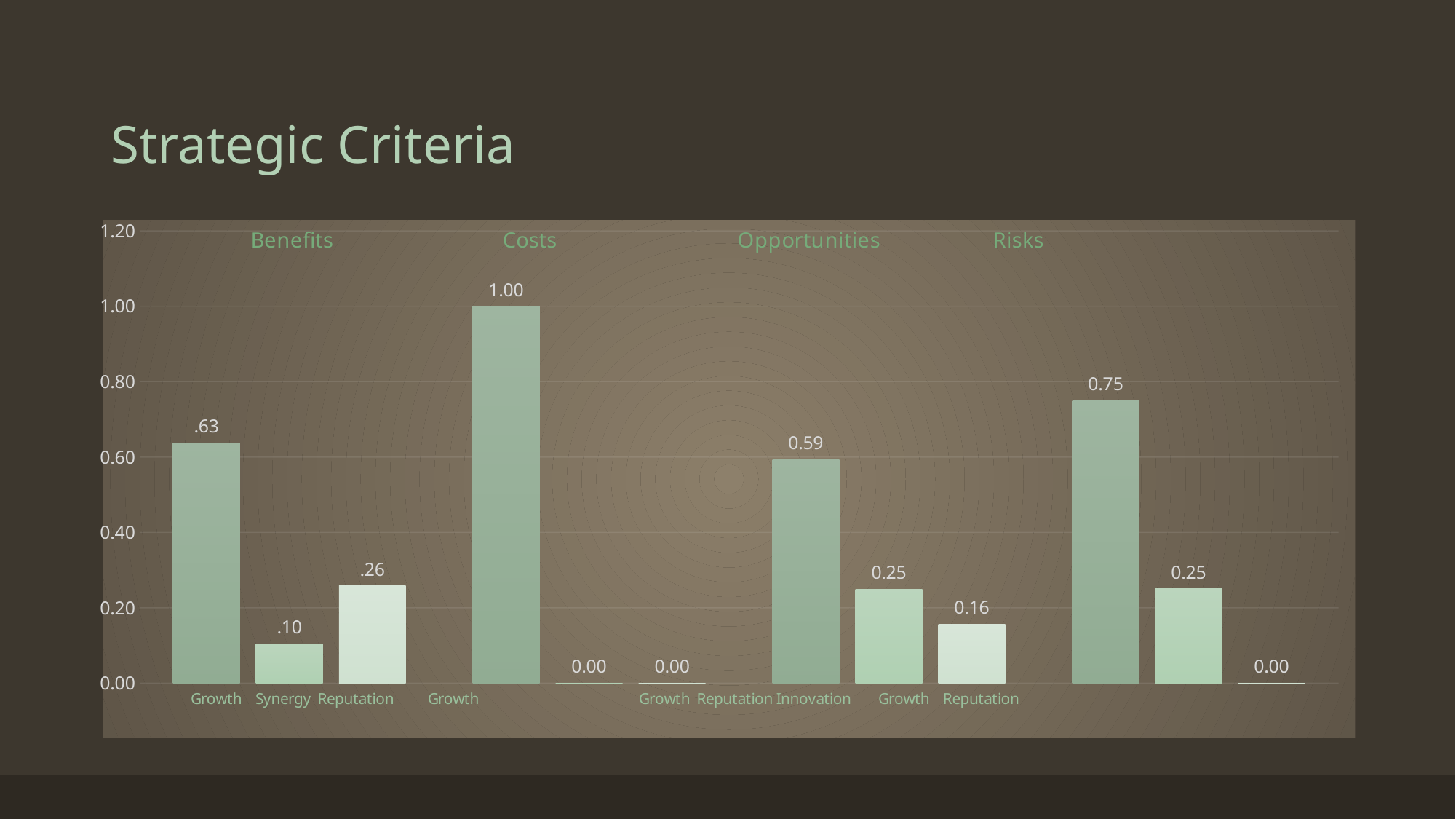
Which bar has the highest value on the chart? Growth (Costs), 1.00 What is the value of the Reputation bar in the Benefits group? .26 What kind of chart is shown on the slide? Bar chart What is the value of the tallest bar in the Opportunities group? 0.59 What is the value of the Growth bar in the Costs group? 1.00 What is the value of the Synergy bar in the Benefits group? .10 What is the value of the tallest bar in the Risks group? 0.75 How many group headings (Benefits, Costs, Opportunities, Risks) are shown above the chart? 4 What is the title of the slide? Strategic Criteria What is the difference between the Growth and Reputation bars in the Benefits group? .37 What is the value of the Growth bar in the Benefits group? .63 In the Benefits group, which is larger: Synergy or Reputation? Reputation